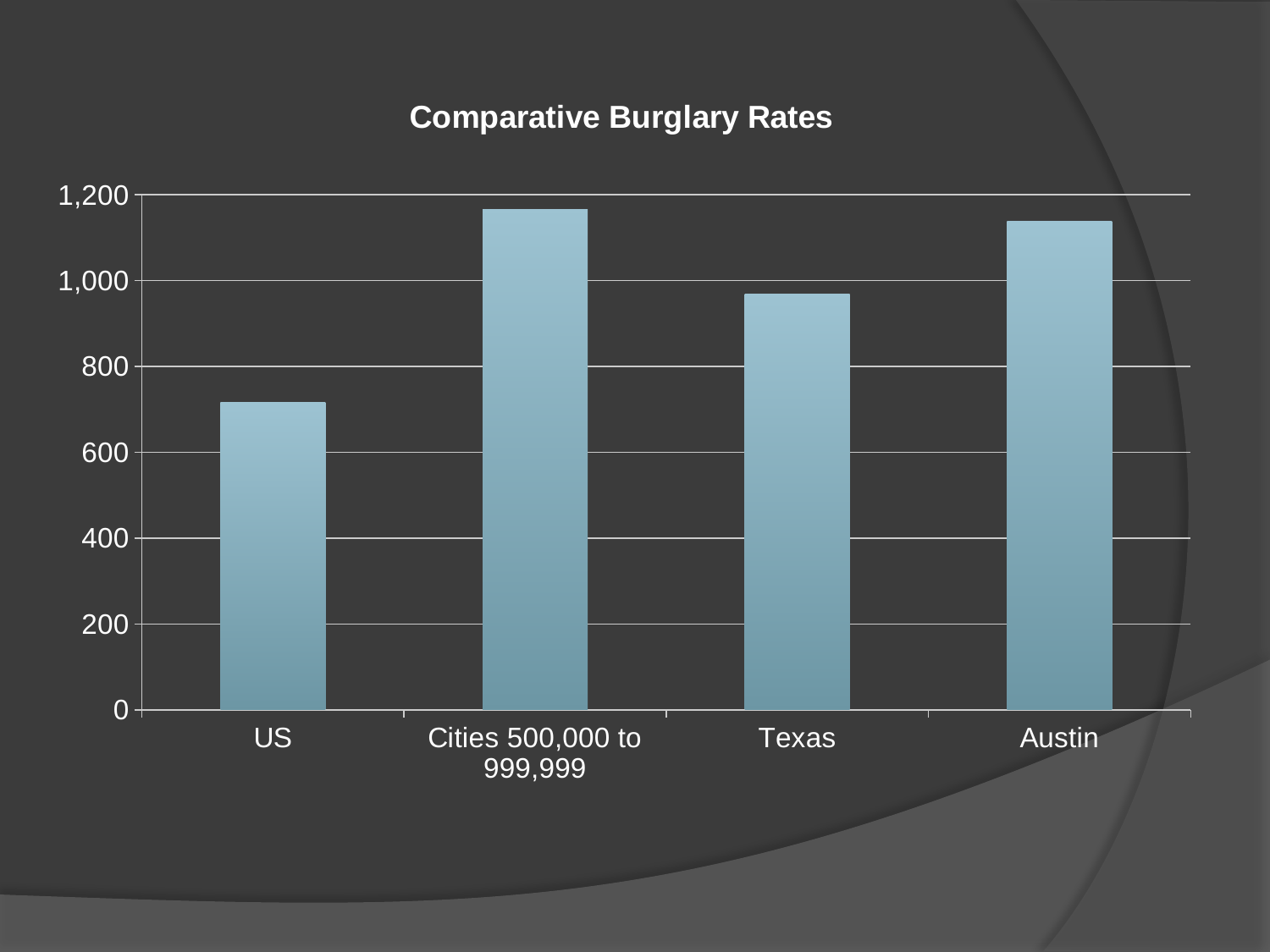
Which has the higher burglary rate, Texas or US? Texas Is the value for US greater or less than 800? less Is the value for US greater or less than 600? greater Which has the higher burglary rate, Austin or Texas? Austin Is the value for Texas greater or less than 1,000? less How many categories are plotted in the chart? 4 Which category has the lowest burglary rate? US What is the title of the chart? Comparative Burglary Rates What kind of chart is shown on the slide? Bar chart What is the highest value shown on the vertical axis? 1,200